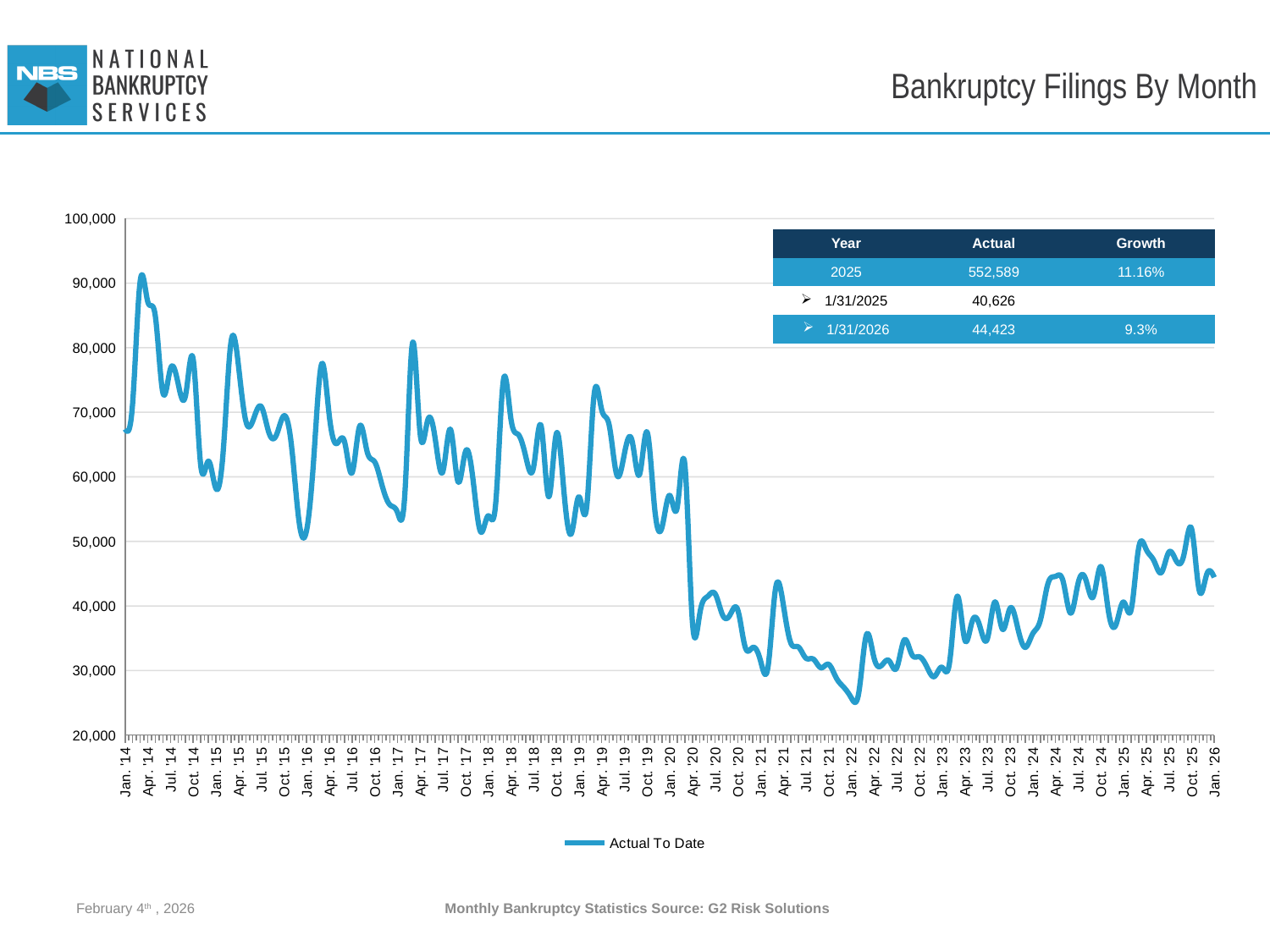
What kind of chart is shown on the slide? line chart Is the value for Jan. '22 greater or less than 30,000? less What is the title of the chart? Bankruptcy Filings By Month According to the table on the chart, what was the actual total for 2025? 552,589 Around which month does the line reach its lowest point? Jan. '22 What is the name of the series shown in the legend? Actual To Date What is the difference between the 1/31/2026 and 1/31/2025 actual values shown in the table? 3,797 Is the value for Jan. '26 greater or less than 50,000? less According to the table on the chart, what was the actual number of filings on 1/31/2025? 40,626 How many series does the legend list? 1 According to the table on the chart, what was the actual number of filings on 1/31/2026? 44,423 Which is larger, the actual value for 1/31/2026 or for 1/31/2025? 1/31/2026